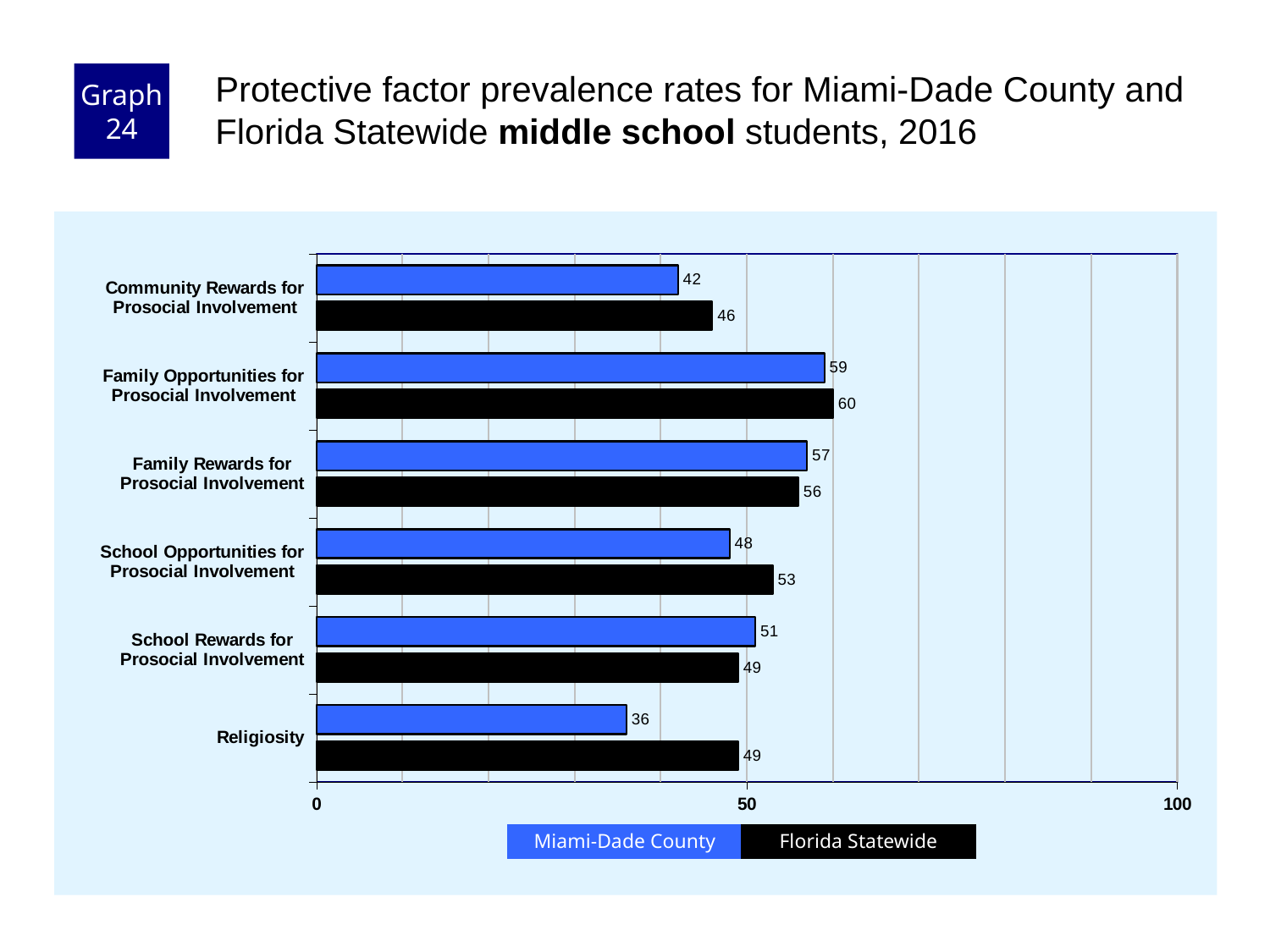
How many series does the legend list? 2 How many categories are shown on the chart? 6 What kind of chart is shown on the slide? bar chart Which colour represents Florida Statewide in the chart? black Which category has the highest Florida Statewide value? Family Opportunities for Prosocial Involvement Which category has the lowest Miami-Dade County value? Religiosity What is the difference between the Florida Statewide and Miami-Dade County values for Religiosity? 13 Is the Miami-Dade County value for School Rewards for Prosocial Involvement greater or less than 50? greater What is the Miami-Dade County value for Family Opportunities for Prosocial Involvement? 59 What is the Florida Statewide value for School Opportunities for Prosocial Involvement? 53 For Community Rewards for Prosocial Involvement, which is larger: the Miami-Dade County value or the Florida Statewide value? Florida Statewide What is the Miami-Dade County value for Religiosity? 36